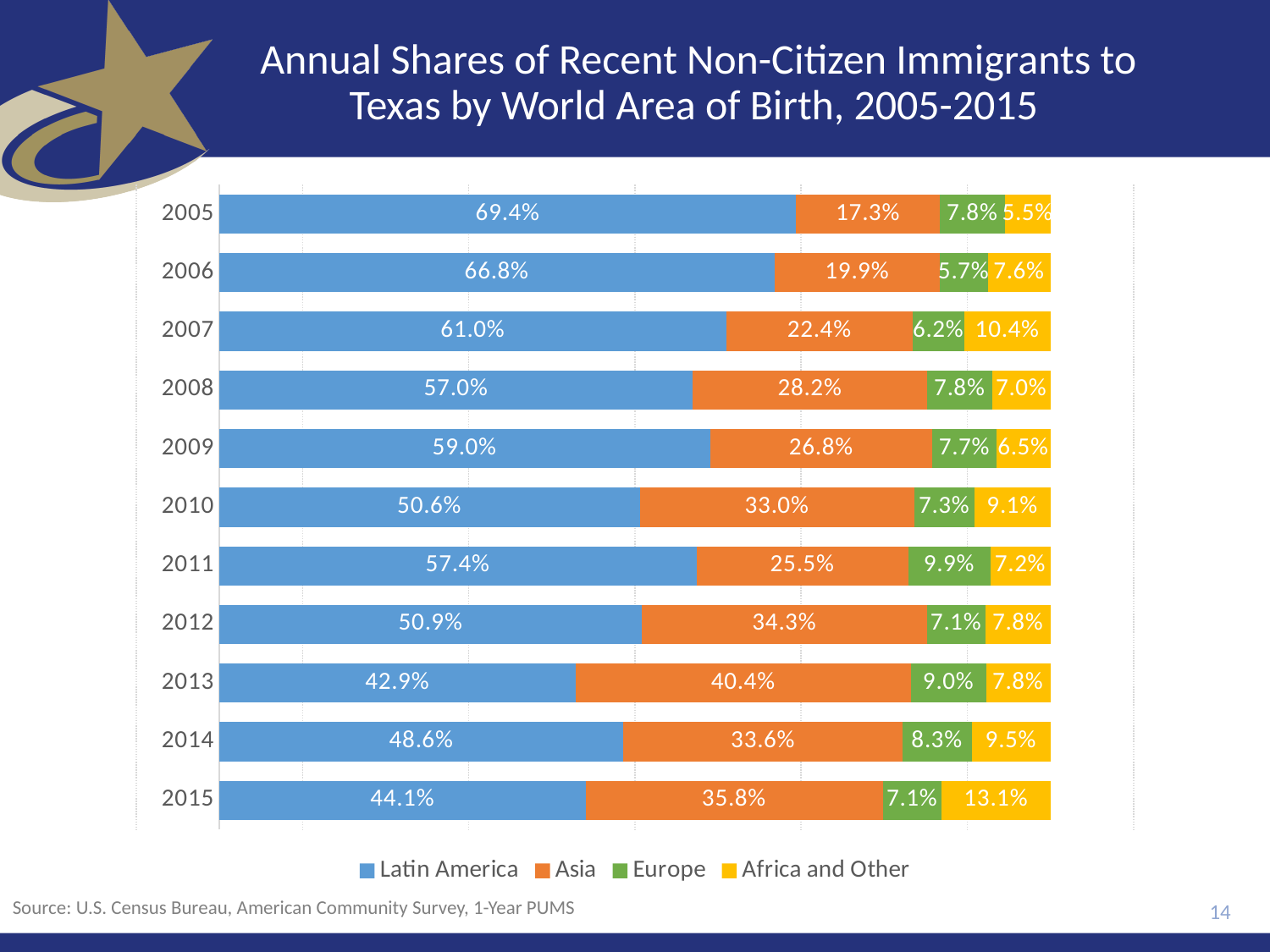
How many years are shown in the chart? 11 In which year was the Europe share lowest? 2006 What share of recent non-citizen immigrants to Texas in 2005 were born in Latin America? 69.4% In which year was the Latin America share highest? 2005 What is the Europe share for 2011? 9.9% In 2013, which was larger: the Latin America share or the Asia share? Latin America By how many percentage points did the Latin America share fall from 2005 to 2015? 25.3 percentage points How many series does the legend list? 4 In which year was the Latin America share lowest? 2013 What is the Africa and Other share for 2015? 13.1% What is the Asia share for 2013? 40.4% In which year was the Asia share highest? 2013